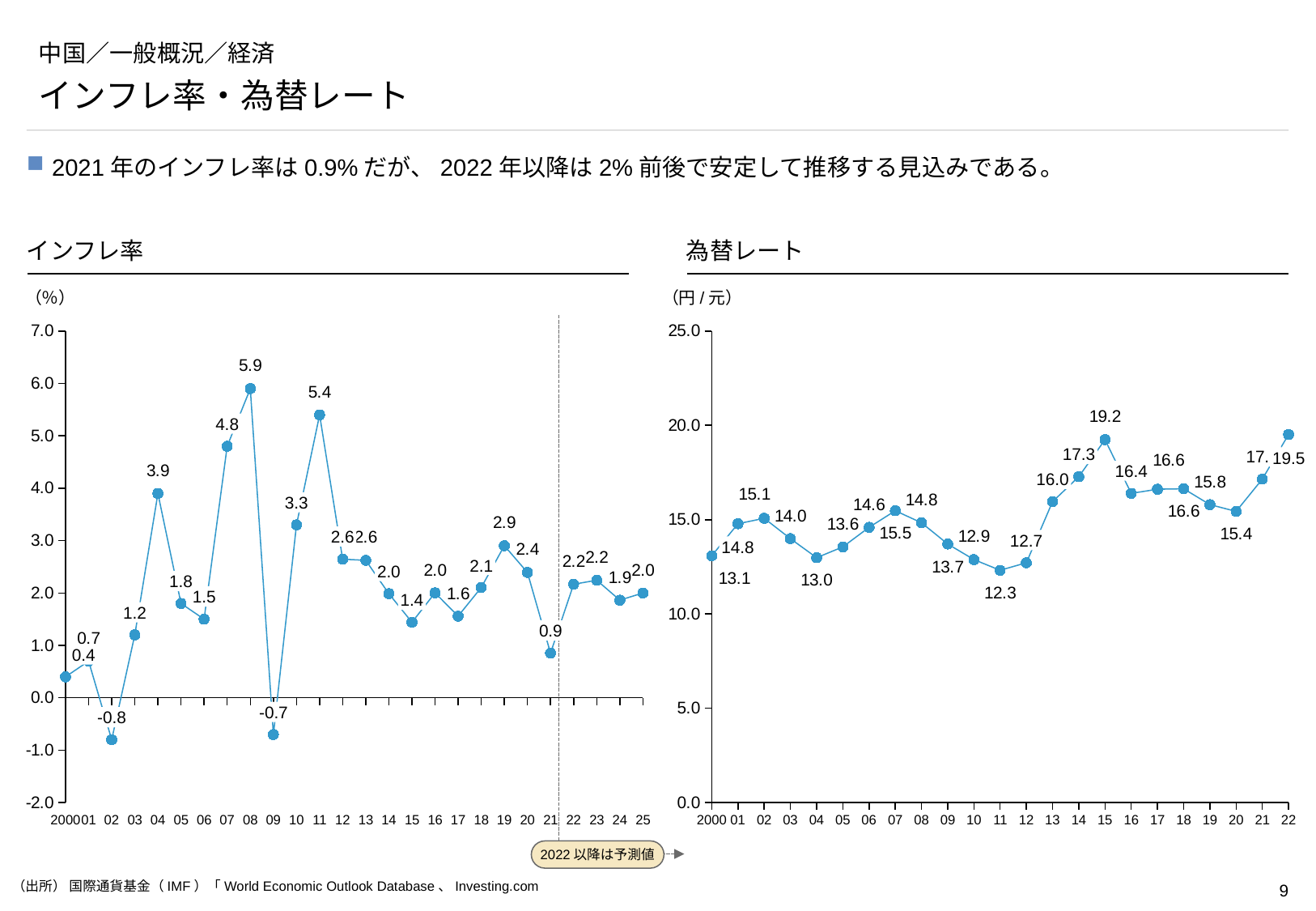
On the インフレ率 chart, which year has the highest inflation rate? 2008 What type of chart is the 為替レート chart? Line chart On the 為替レート chart, what is the difference between the 2015 value and the 2016 value? 2.8 On the インフレ率 chart, which is larger, the value for 2004 or the value for 2007? 2007 On the インフレ率 chart, which year has the lowest inflation rate? 2002 On the 為替レート chart, which year has the highest exchange rate? 2022 On the 為替レート chart, which year has the lowest exchange rate? 2011 On the インフレ率 chart, what is the inflation rate for 2008? 5.9 On the インフレ率 chart, what is the difference between the 2011 value and the 2010 value? 2.1 On the インフレ率 chart, what is the inflation rate for 2021? 0.9 On the 為替レート chart, what is the exchange rate for 2015? 19.2 On the 為替レート chart, what unit is shown on the y axis? 円/元